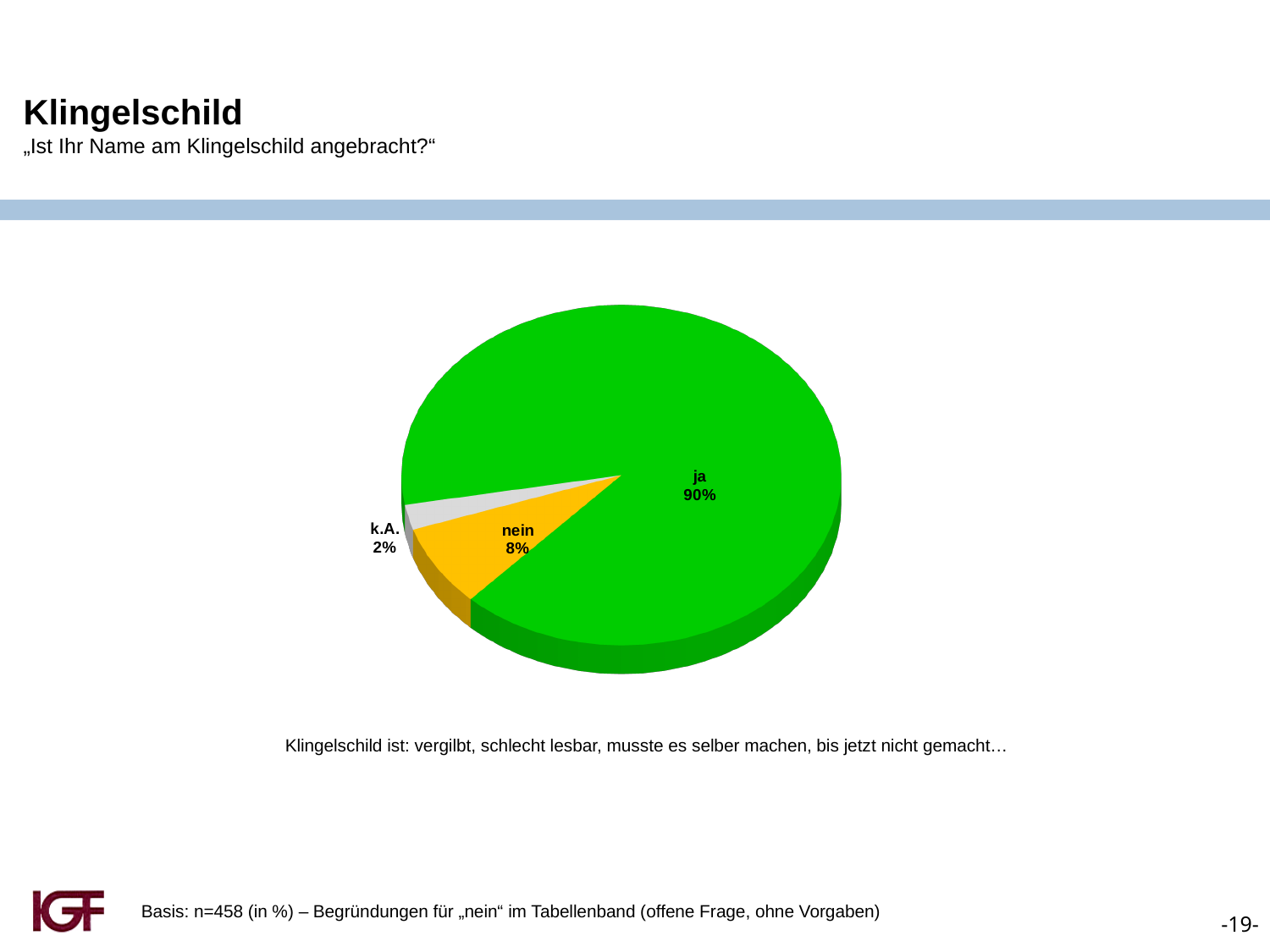
What percentage of respondents answered "nein"? 8% Which slice of the pie is the largest? ja What percentage of respondents answered "ja"? 90% What is the difference in percentage points between "nein" and "k.A."? 6 What type of chart is shown on the slide? pie chart Which slice of the pie is the smallest? k.A. What is the difference in percentage points between "ja" and "nein"? 82 What is the sample size (n) stated at the bottom of the slide? n=458 Which is larger, the share for "nein" or the share for "k.A."? nein How many slices does the pie chart have? 3 What percentage is shown for "k.A."? 2% What colour is the "ja" slice of the pie? green